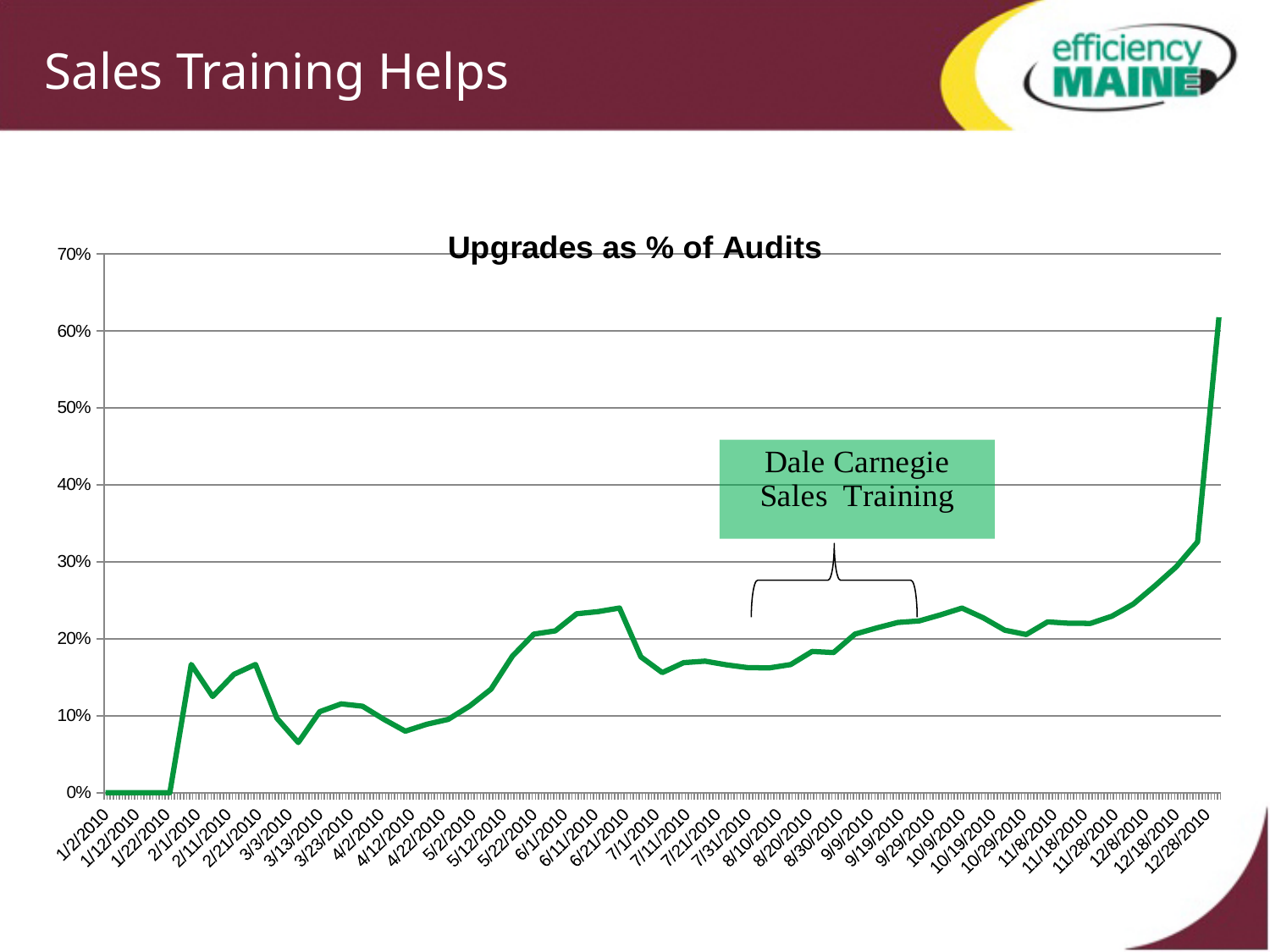
Overall, does the value rise or fall from the start of 2010 to the end of 2010? rise What is the highest value shown on the vertical axis? 70% What is the title of the chart? Upgrades as % of Audits Is the value for 4/12/2010 greater or less than 20%? less What is the value of Upgrades as % of Audits on 1/2/2010? 0% Is the value for 12/18/2010 greater or less than 20%? greater What kind of chart is shown on the slide? line chart Is the value for 10/9/2010 greater or less than 30%? less How many lines are plotted on the chart? 1